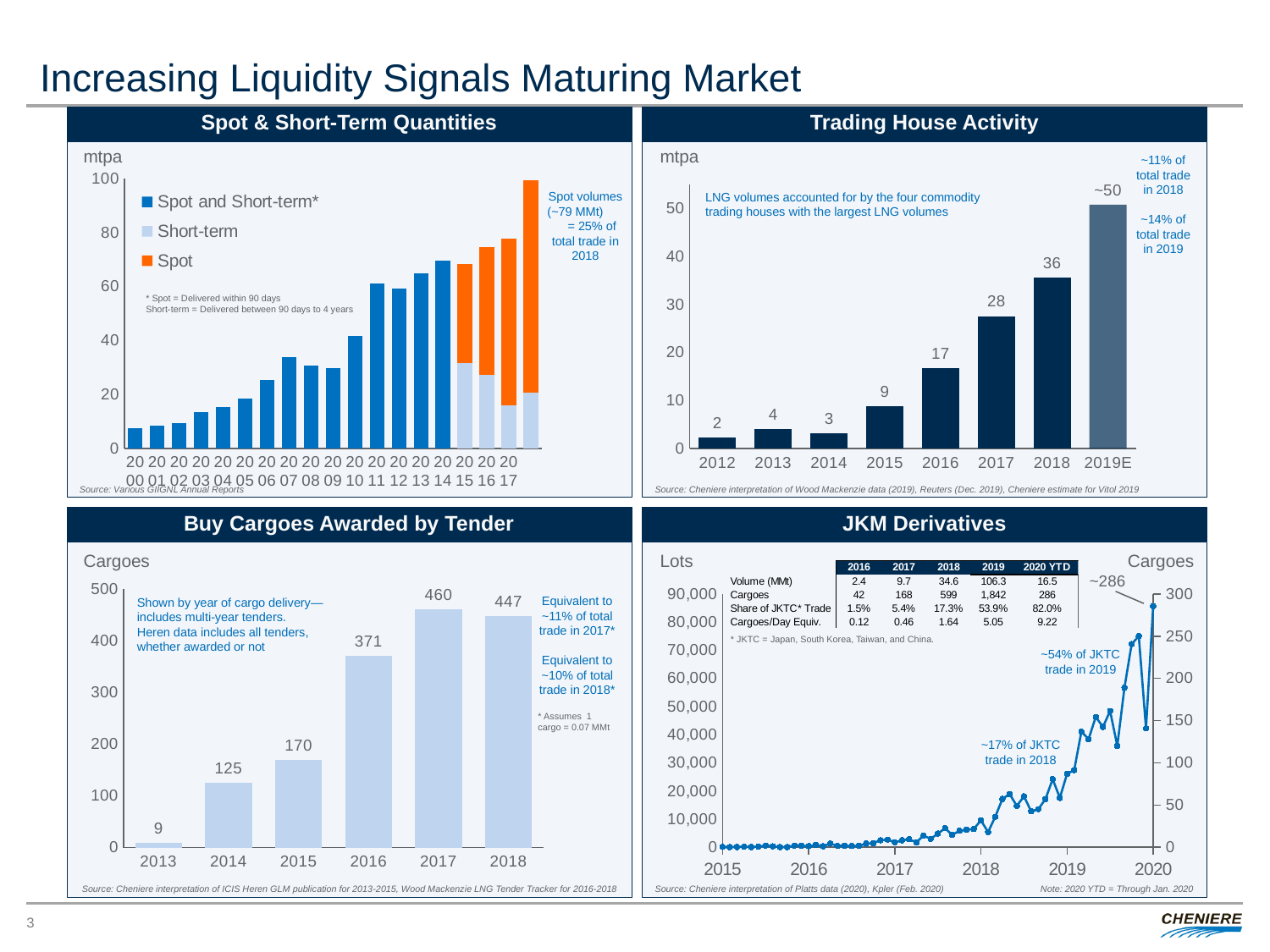
In the Trading House Activity chart, how many years are shown on the x axis? 8 In the Spot & Short-Term Quantities chart, is the value for 2017 greater or less than 80? less In the Buy Cargoes Awarded by Tender chart, which year has the highest value? 2017 In the Trading House Activity chart, do the values generally rise or fall from 2014 to 2019E? Rise In the Trading House Activity chart, what is the difference between the values for 2018 and 2016? 19 What kind of chart is the JKM Derivatives chart? Line chart In the Trading House Activity chart, which year has the lowest value? 2012 In the Buy Cargoes Awarded by Tender chart, which is larger, the value for 2014 or the value for 2015? 2015 In the Buy Cargoes Awarded by Tender chart, what is the difference between the values for 2017 and 2018? 13 In the Trading House Activity chart, what is the value for 2017? 28 In the Buy Cargoes Awarded by Tender chart, what is the value for 2016? 371 In the Spot & Short-Term Quantities chart, how many series does the legend list? 3